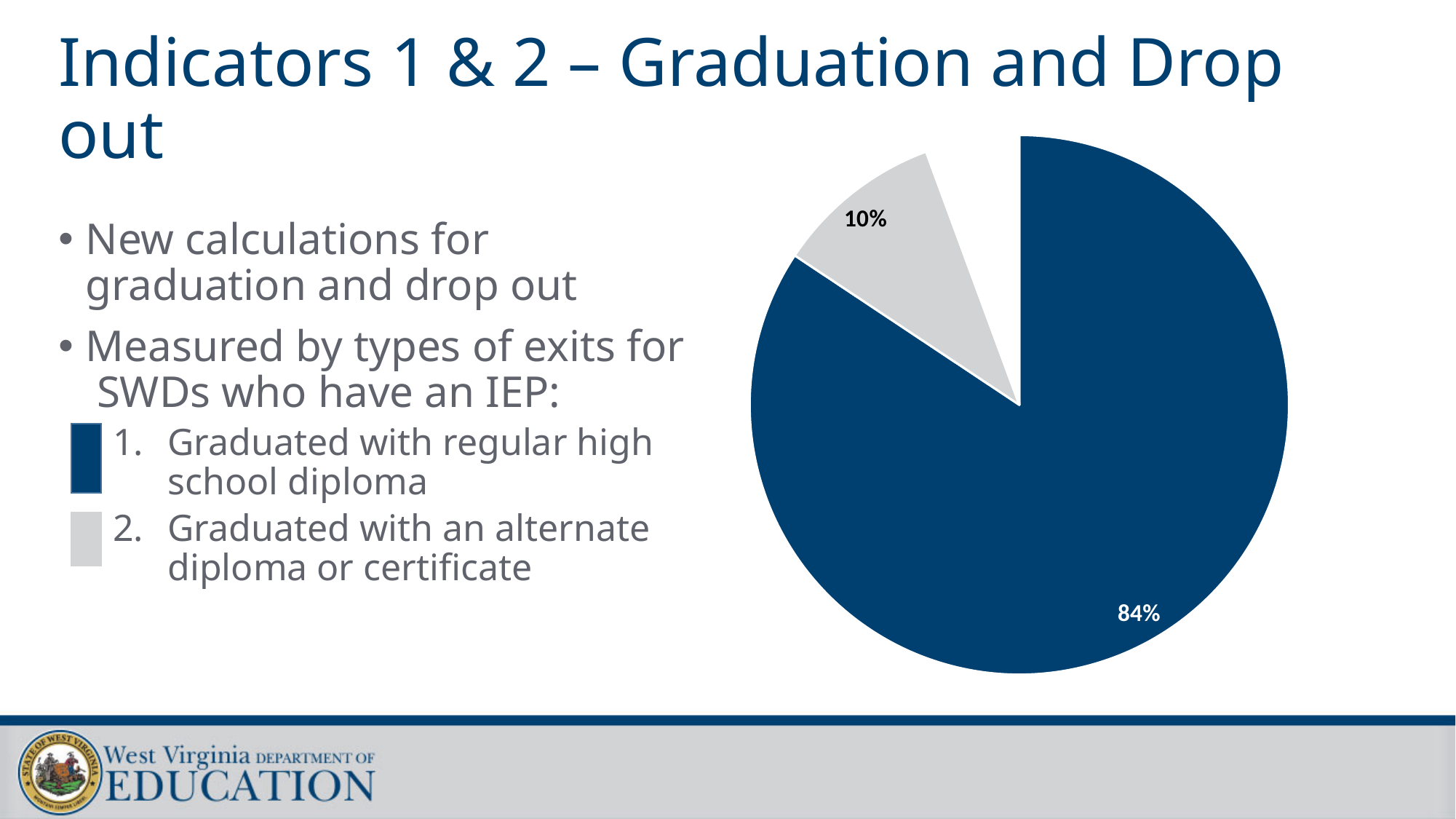
What percentage of the pie is labelled for the dark blue slice (graduated with regular high school diploma)? 84% What colour is the slice representing graduated with an alternate diploma or certificate? grey What is the difference in percentage points between the regular high school diploma slice and the alternate diploma or certificate slice? 74 What is the share of the pie labelled for the alternate diploma or certificate slice? 10% Which exit type has the largest slice of the pie? Graduated with regular high school diploma What percentage of the pie is labelled for the grey slice (graduated with an alternate diploma or certificate)? 10% Which is larger: the slice for graduated with regular high school diploma or the slice for graduated with an alternate diploma or certificate? Graduated with regular high school diploma What colour is the slice representing graduated with regular high school diploma? dark blue What kind of chart is shown on the slide? pie chart